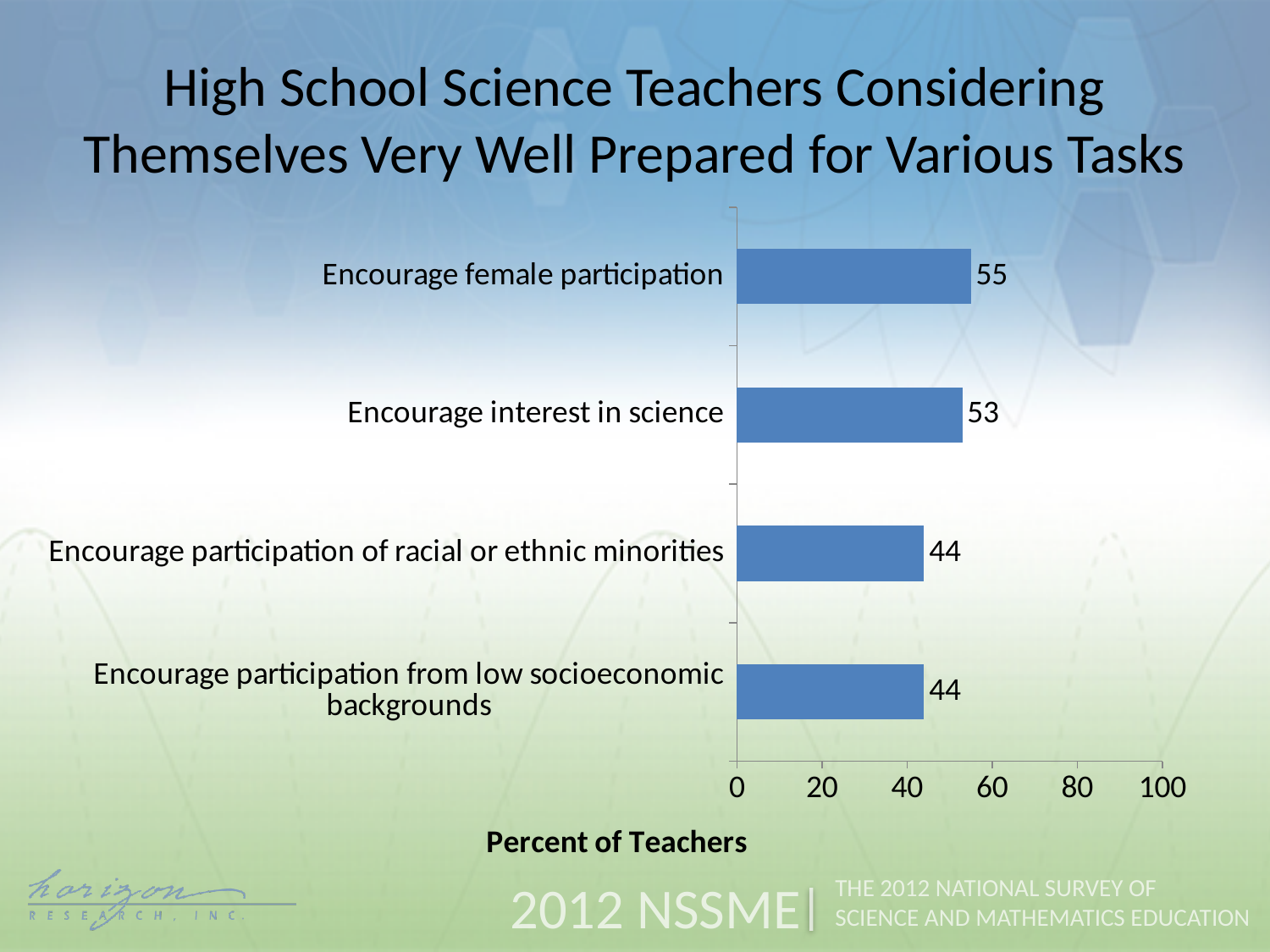
Is the value for 'Encourage female participation' greater or less than 60? less What percent of teachers consider themselves very well prepared to encourage female participation? 55 What is the value for 'Encourage participation from low socioeconomic backgrounds'? 44 What is the difference between the values for 'Encourage female participation' and 'Encourage interest in science'? 2 Which task has the highest percent of teachers considering themselves very well prepared? Encourage female participation What is the label of the horizontal axis? Percent of Teachers Which is larger: the value for 'Encourage interest in science' or the value for 'Encourage participation from low socioeconomic backgrounds'? Encourage interest in science What is the value for 'Encourage participation of racial or ethnic minorities'? 44 What is the difference between the values for 'Encourage female participation' and 'Encourage participation of racial or ethnic minorities'? 11 How many tasks (categories) are shown in the chart? 4 What is the value for 'Encourage interest in science'? 53 What kind of chart is shown on the slide? bar chart